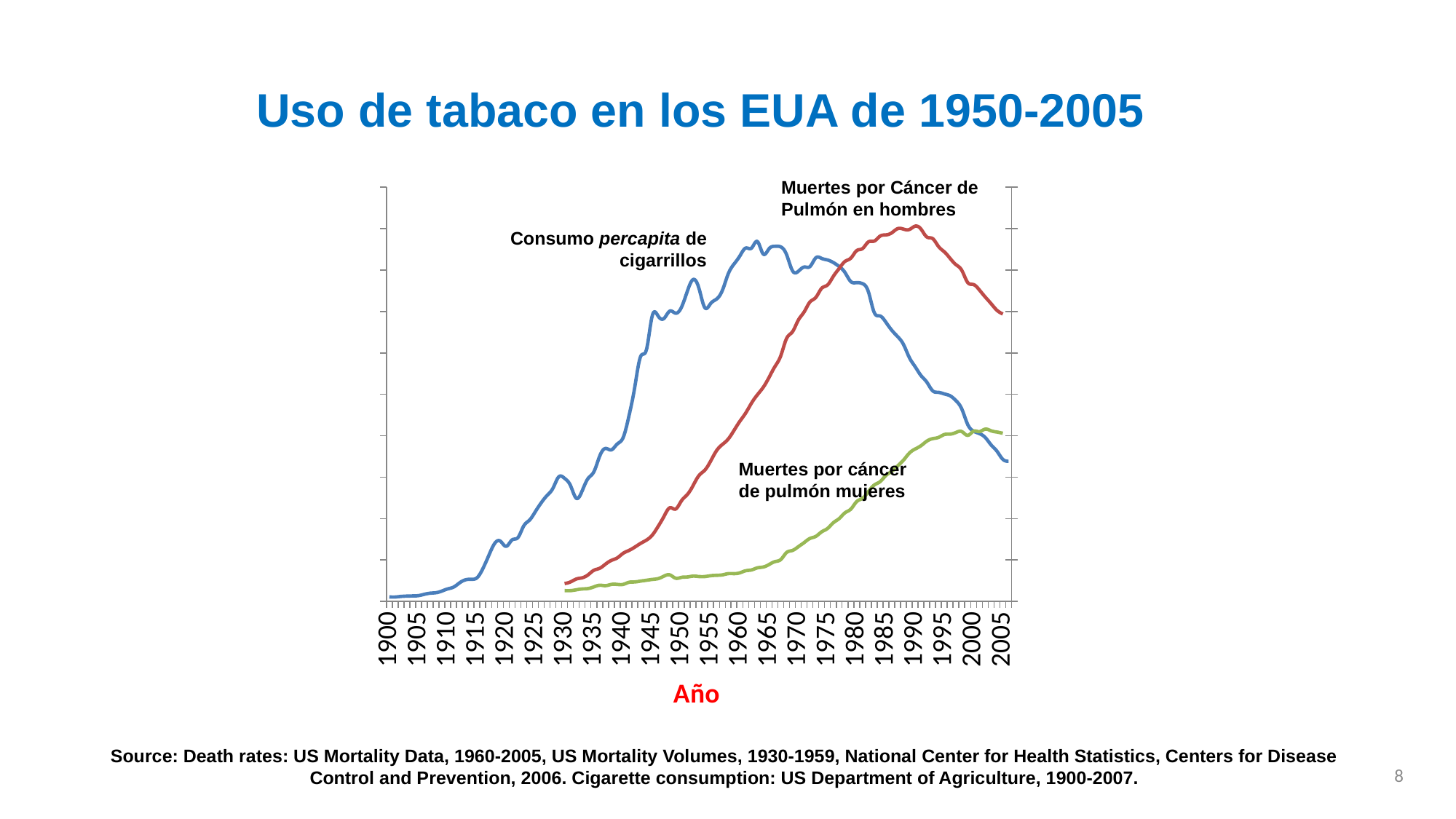
What label is shown on the x axis of the chart? Año What is the title of the slide's chart? Uso de tabaco en los EUA de 1950-2005 What kind of chart is shown on the slide? Line chart Does the 'Muertes por Cáncer de Pulmón en hombres' line rise or fall between 1990 and 2005? Fall Which series is the lowest in 1960? Muertes por cáncer de pulmón mujeres Does the 'Consumo percapita de cigarrillos' line rise or fall between 1900 and 1960? Rise In 2005, which is higher: 'Muertes por Cáncer de Pulmón en hombres' or 'Muertes por cáncer de pulmón mujeres'? Muertes por Cáncer de Pulmón en hombres What is the first year shown on the x axis? 1900 How many data series are plotted on the chart? 3 Does the 'Consumo percapita de cigarrillos' line rise or fall between 1970 and 2005? Fall In 1950, which is higher: 'Consumo percapita de cigarrillos' or 'Muertes por Cáncer de Pulmón en hombres'? Consumo percapita de cigarrillos